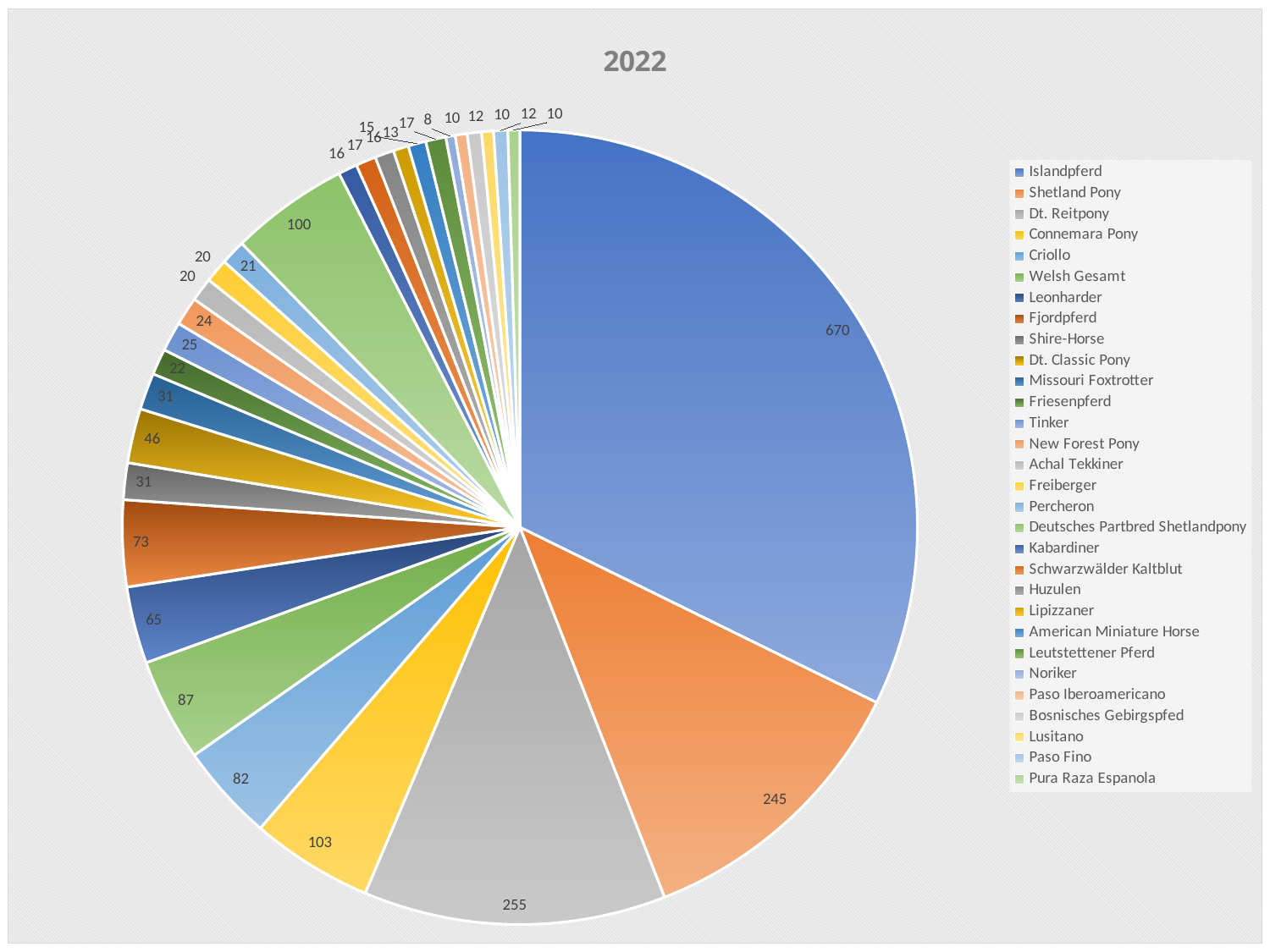
Which is larger, the value for Welsh Gesamt or the value for Criollo? Welsh Gesamt What is the difference between the values for Islandpferd and Dt. Reitpony? 415 What kind of chart is shown? Pie chart What is the value for Fjordpferd? 73 Which category has the largest slice? Islandpferd Which category has the smallest slice? Noriker What is the difference between the values for Dt. Reitpony and Shetland Pony? 10 How many categories does the legend list? 30 What is the value for Islandpferd? 670 What is the value for Connemara Pony? 103 What is the value for Shetland Pony? 245 What is the value for Dt. Reitpony? 255